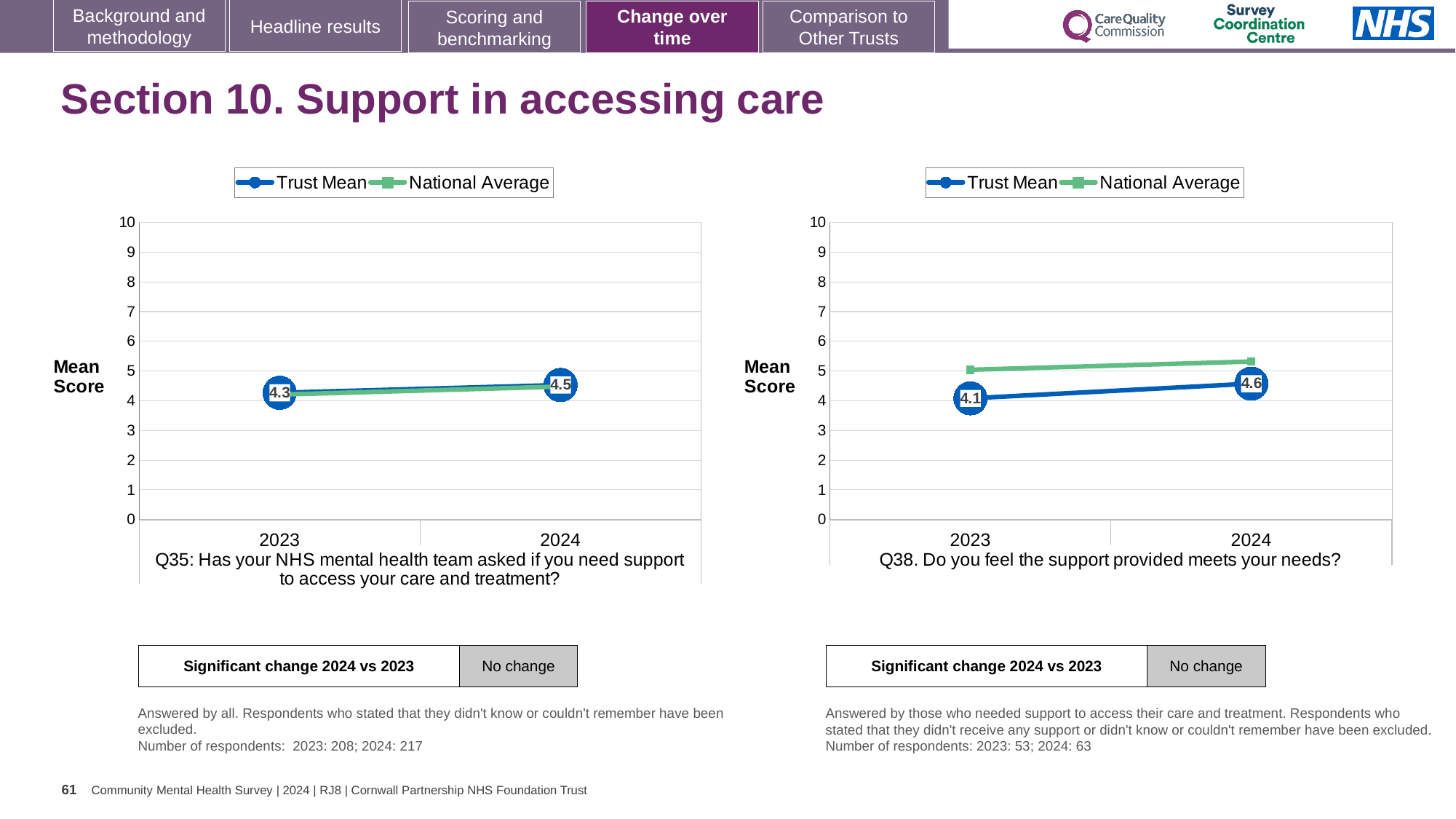
What type of chart is the Q35 chart (left)? line chart How many years are plotted on the x axis of the Q38 chart (right)? 2 How many series does the legend of the Q35 chart (left) list? 2 In the Q38 chart (right), what is the Trust Mean score for 2023? 4.1 In the Q38 chart (right), does the Trust Mean rise or fall from 2023 to 2024? rise In the Q35 chart (left), what is the Trust Mean score for 2023? 4.3 In the Q38 chart (right), is the National Average for 2024 greater or less than 5? greater In the Q38 chart (right), by how much did the Trust Mean change from 2023 to 2024? 0.5 In the Q38 chart (right), what is the Trust Mean score for 2024? 4.6 In the Q35 chart (left), what is the Trust Mean score for 2024? 4.5 In the Q38 chart (right), which is higher in 2023, the Trust Mean or the National Average? National Average In the Q35 chart (left), by how much did the Trust Mean change from 2023 to 2024? 0.2